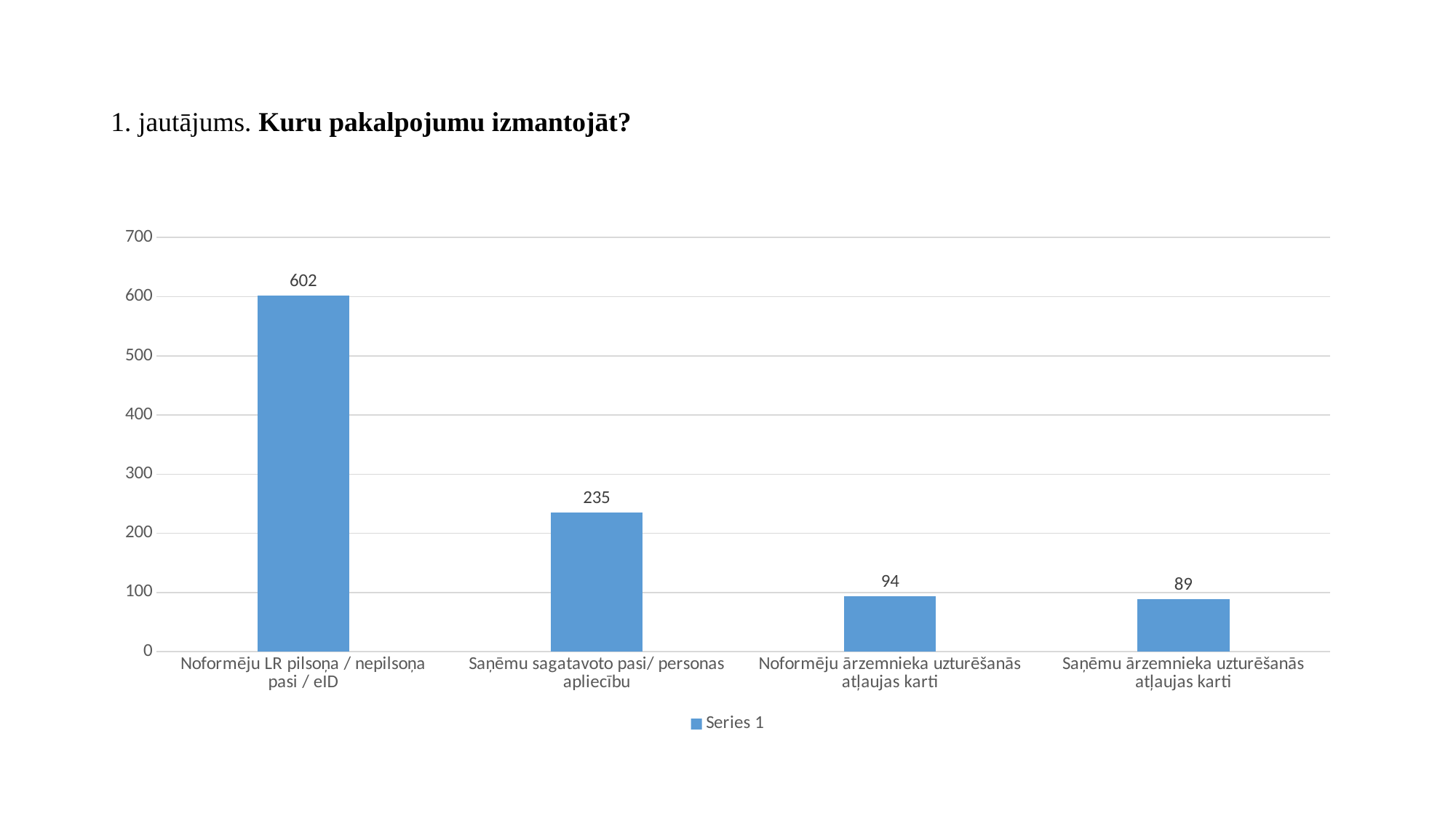
Which is larger: the value for "Saņēmu sagatavoto pasi/ personas apliecību" or the value for "Noformēju ārzemnieka uzturēšanās atļaujas karti"? Saņēmu sagatavoto pasi/ personas apliecību What is the value for "Saņēmu ārzemnieka uzturēšanās atļaujas karti"? 89 Which category has the lowest value? Saņēmu ārzemnieka uzturēšanās atļaujas karti What kind of chart is shown on the slide? Bar chart What is the difference between the values for "Noformēju ārzemnieka uzturēšanās atļaujas karti" and "Saņēmu ārzemnieka uzturēšanās atļaujas karti"? 5 How many categories are shown on the x axis? 4 How many series does the legend list? 1 What is the value for "Noformēju LR pilsoņa / nepilsoņa pasi / eID"? 602 Which category has the highest value? Noformēju LR pilsoņa / nepilsoņa pasi / eID What is the difference between the values for "Noformēju LR pilsoņa / nepilsoņa pasi / eID" and "Saņēmu sagatavoto pasi/ personas apliecību"? 367 What is the value for "Saņēmu sagatavoto pasi/ personas apliecību"? 235 What is the value for "Noformēju ārzemnieka uzturēšanās atļaujas karti"? 94